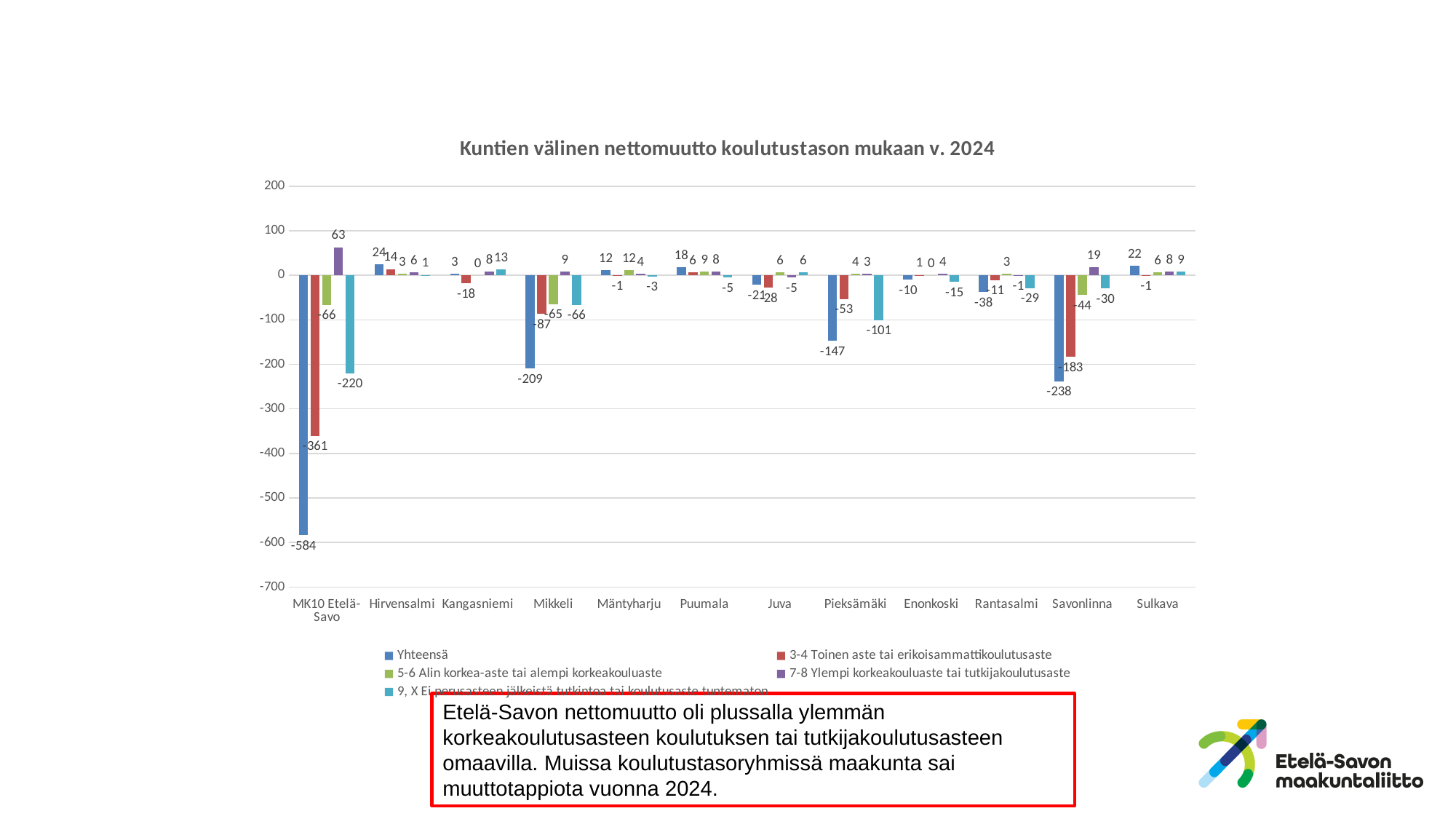
What is the title of the chart? Kuntien välinen nettomuutto koulutustason mukaan v. 2024 What is the Yhteensä value for Savonlinna? -238 What is the value of the 9, X series for Pieksämäki? -101 Which category has the lowest Yhteensä value? MK10 Etelä-Savo Which is larger, the 3-4 Toinen aste value for Savonlinna or for Mikkeli? Mikkeli How many municipalities/categories are shown on the x axis? 12 What is the Yhteensä value for MK10 Etelä-Savo? -584 Which municipality has the highest Yhteensä value? Hirvensalmi What is the value of the 7-8 Ylempi korkeakouluaste tai tutkijakoulutusaste series for MK10 Etelä-Savo? 63 How many series does the legend list? 5 What kind of chart is shown on the slide? Bar chart What is the difference between the Yhteensä values for Mikkeli and Pieksämäki? 62